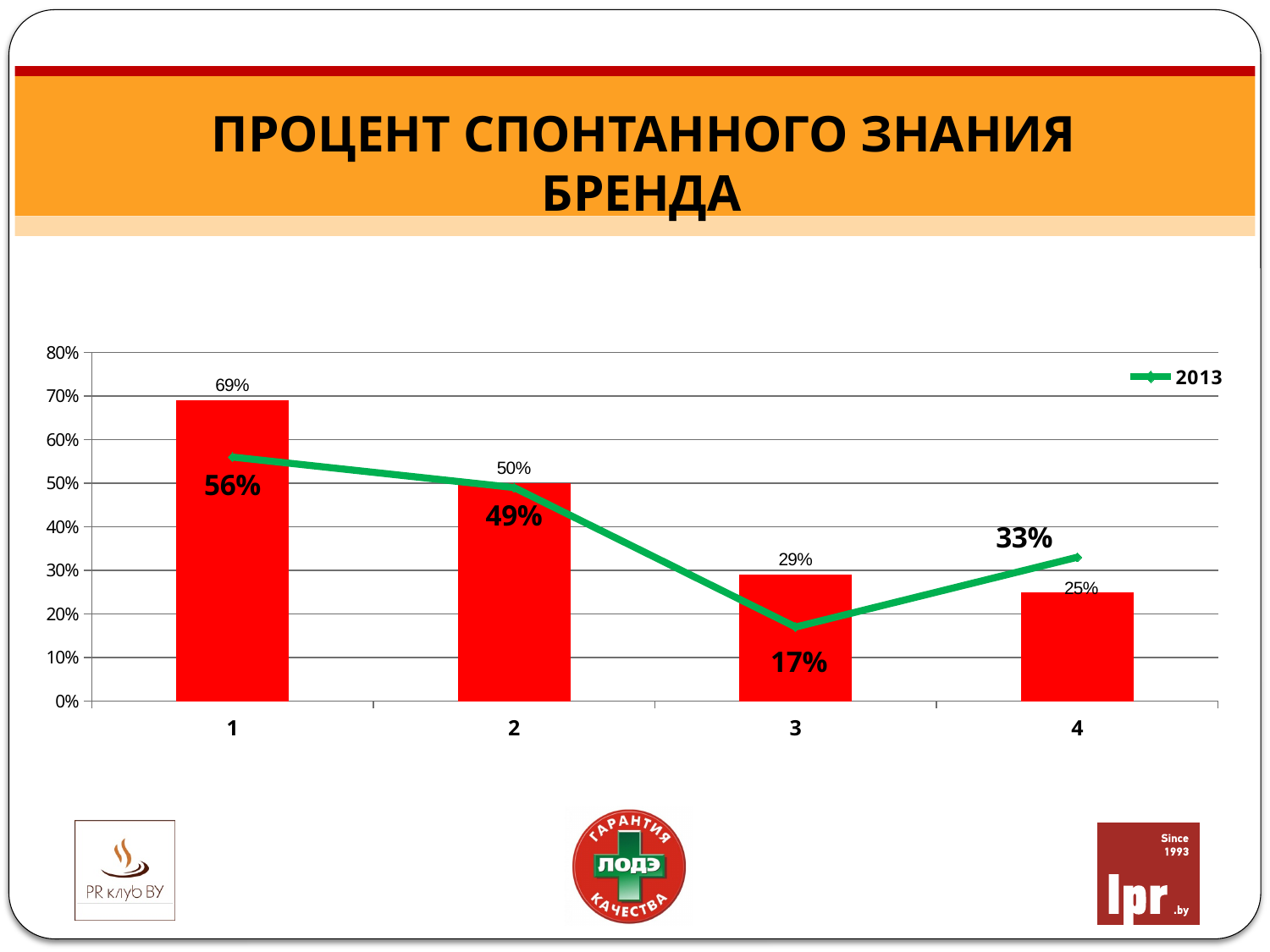
What is the value of the 2013 line at category 4? 33% What is the value of the red bar for category 1? 69% How many series does the legend list? 1 At category 4, which is larger: the red bar or the 2013 line value? the 2013 line value How many categories are shown on the x axis? 4 What is the difference between the red bar values for category 1 and category 2? 19% What is the value of the 2013 line at category 3? 17% What is the difference between the 2013 line value and the red bar value at category 4? 8% What is the title of the chart slide? ПРОЦЕНТ СПОНТАННОГО ЗНАНИЯ БРЕНДА Which category has the highest red bar? 1 Which category has the lowest value on the 2013 line? 3 Do the red bar values rise or fall from category 1 to category 4? fall